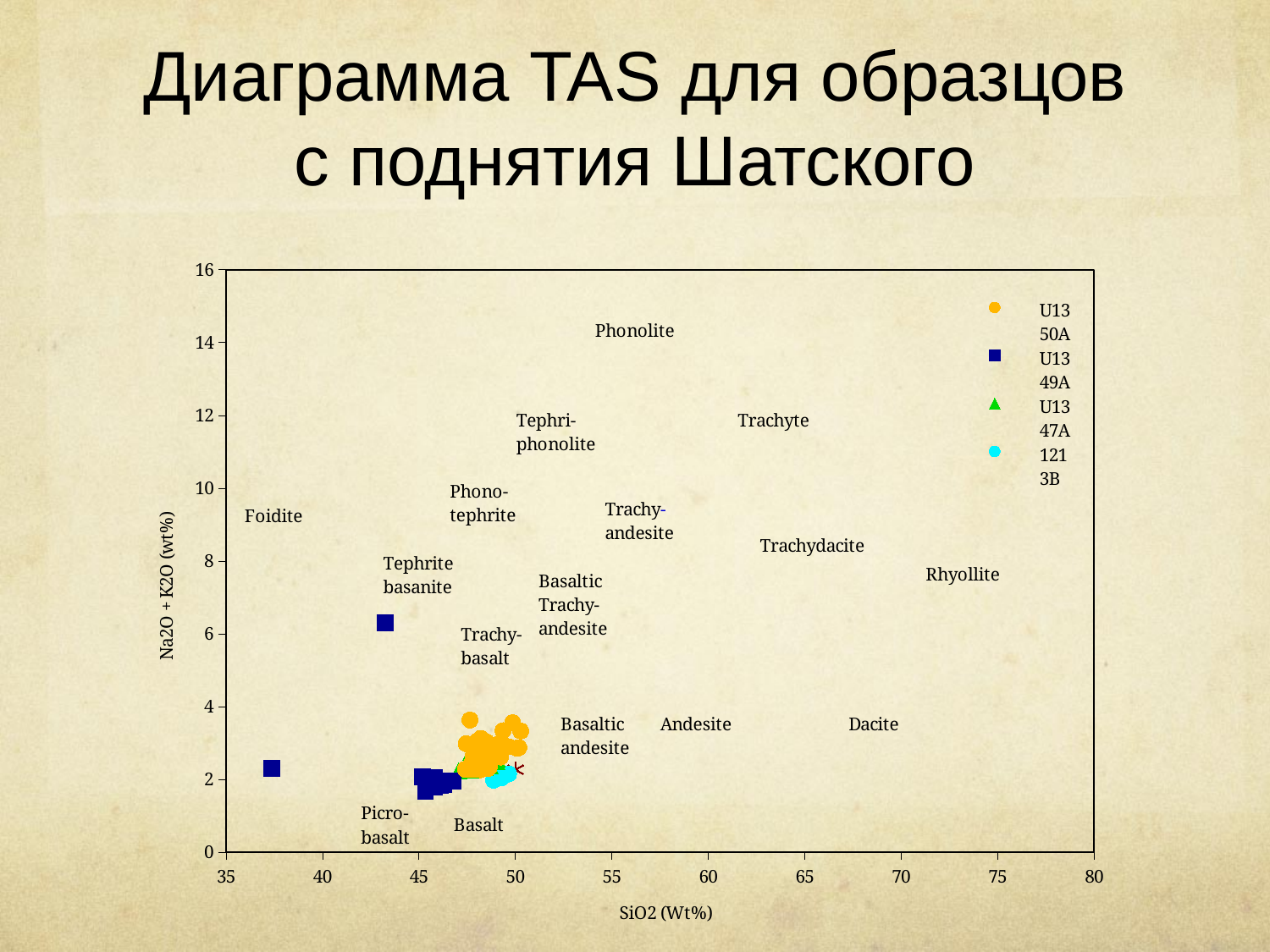
What is the title of the x axis? SiO2 (Wt%) Which series has the point with the highest Na2O + K2O value? U13 49A Is the Na2O + K2O value of the leftmost U13 49A point (near SiO2 of 37) greater or less than 4? less Are the SiO2 values of the U13 50A points greater or less than 55? less Are the Na2O + K2O values of the U13 50A points greater or less than 6? less What is the title of the y axis? Na2O + K2O (wt%) How many series does the legend list? 4 What kind of chart is shown on the slide? scatter chart Which series has the point with the lowest SiO2 value? U13 49A Which series is plotted with orange circles? U13 50A